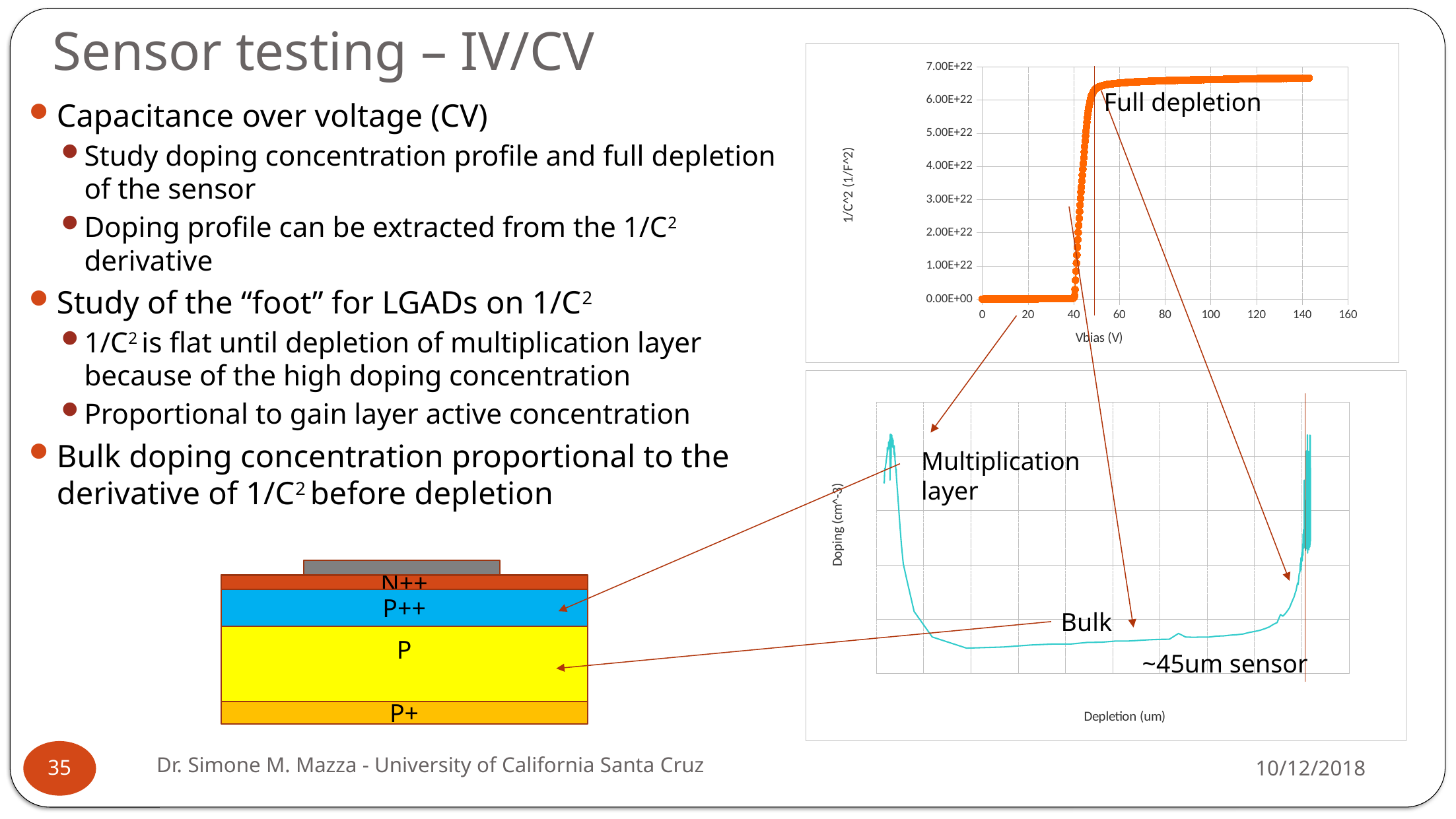
In the top-right chart, is the 1/C^2 value at Vbias 60 V larger or smaller than at Vbias 20 V? larger In the bottom-right chart, is the doping at the Multiplication layer peak higher or lower than in the Bulk region? higher In the bottom-right chart, moving right from the Multiplication layer peak into the Bulk region, does the doping rise or fall? fall In the top-right chart, is the 1/C^2 value at Vbias 100 V greater or less than 6.00E+22? greater In the top-right chart, is the 1/C^2 value at Vbias 140 V greater or less than 7.00E+22? less What kind of chart is the bottom-right chart of Doping versus Depletion? line chart What kind of chart is the top-right chart of 1/C^2 versus Vbias? scatter chart What is the x-axis label of the top-right chart? Vbias (V) In the top-right chart, is the 1/C^2 value at Vbias 20 V greater or less than 1.00E+22? less What is the y-axis label of the bottom-right chart? Doping (cm^-3) In the top-right chart, does 1/C^2 rise or fall as Vbias increases from 0 to 140 V? rise